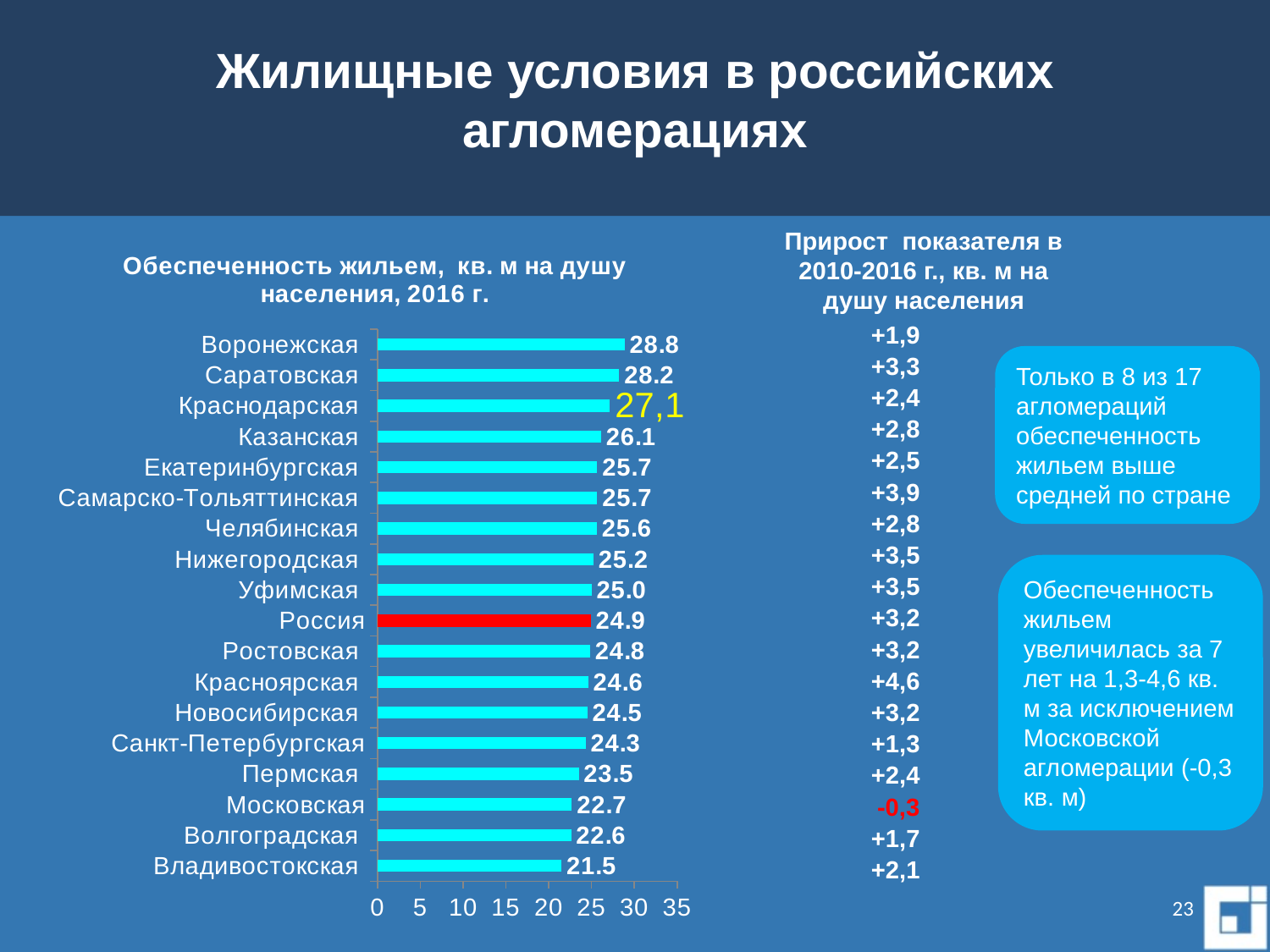
What is the value for Воронежская in the chart? 28.8 Which is larger, the value for Казанская or the value for Пермская? Казанская How many categories are shown in the chart? 18 What is the value for Краснодарская in the chart? 27,1 Which category has the highest value in the chart? Воронежская Is the value for Саратовская greater or less than 25? greater What is the difference between the values for Воронежская and Владивостокская? 7.3 What kind of chart is shown on the slide? bar chart What is the value for Россия in the chart? 24.9 What is the value for Московская in the chart? 22.7 Which category has the lowest value in the chart? Владивостокская Which category's bar is coloured red in the chart? Россия